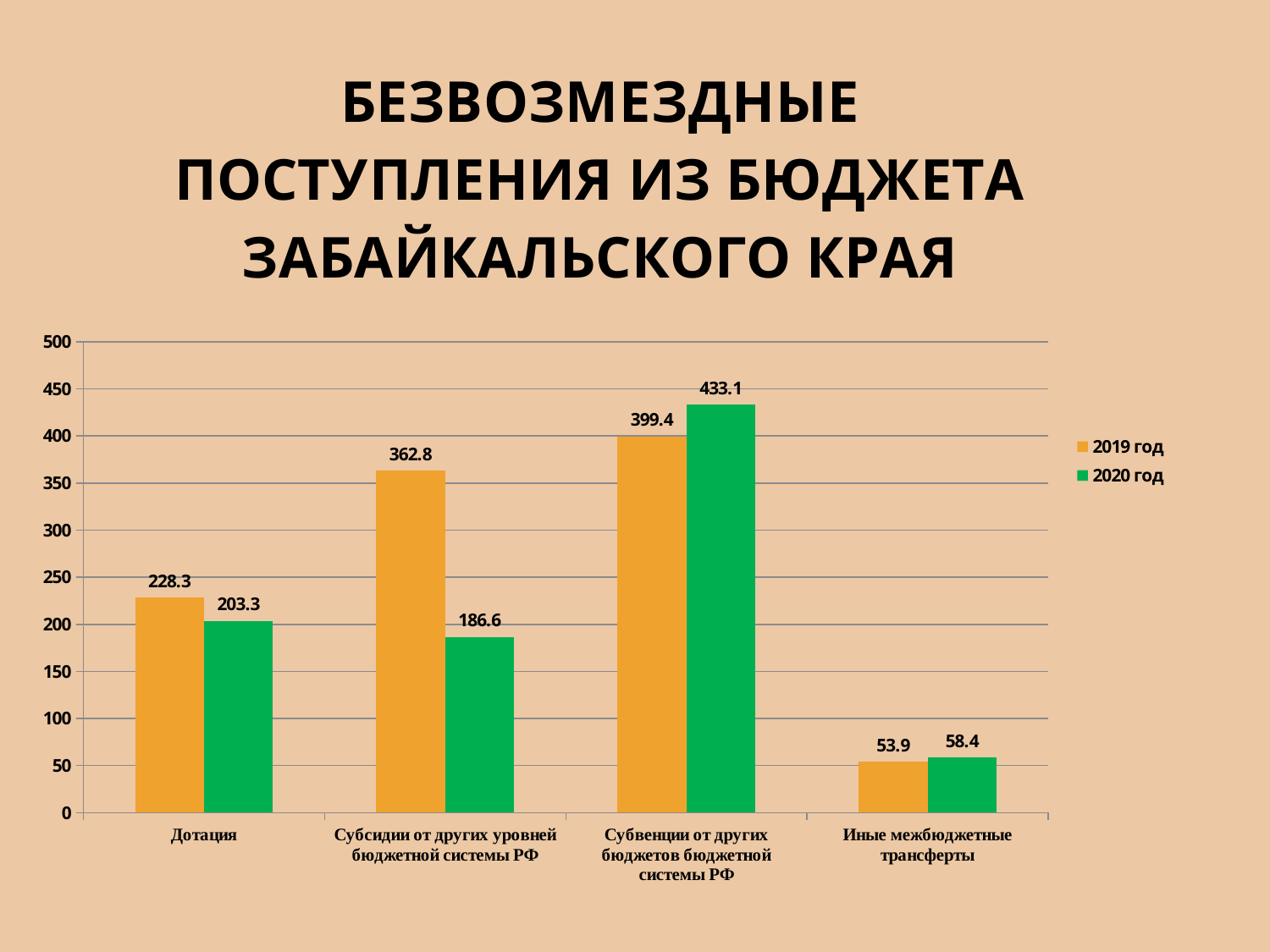
What is the difference between the 2020 год and 2019 год values for Субвенции от других бюджетов бюджетной системы РФ? 33.7 What is the difference between the 2019 год and 2020 год values for Субсидии от других уровней бюджетной системы РФ? 176.2 How many series does the legend list? 2 What kind of chart is shown on the slide? bar chart Is the 2020 год value for Субвенции от других бюджетов бюджетной системы РФ greater or less than 400? greater What is the value for Дотация in 2019 год? 228.3 What is the value for Иные межбюджетные трансферты in 2019 год? 53.9 Which is larger for Дотация: the 2019 год value or the 2020 год value? 2019 год Which category has the highest value in 2020 год? Субвенции от других бюджетов бюджетной системы РФ What is the value for Субсидии от других уровней бюджетной системы РФ in 2020 год? 186.6 Which category has the lowest value in 2019 год? Иные межбюджетные трансферты How many categories are shown on the x axis? 4